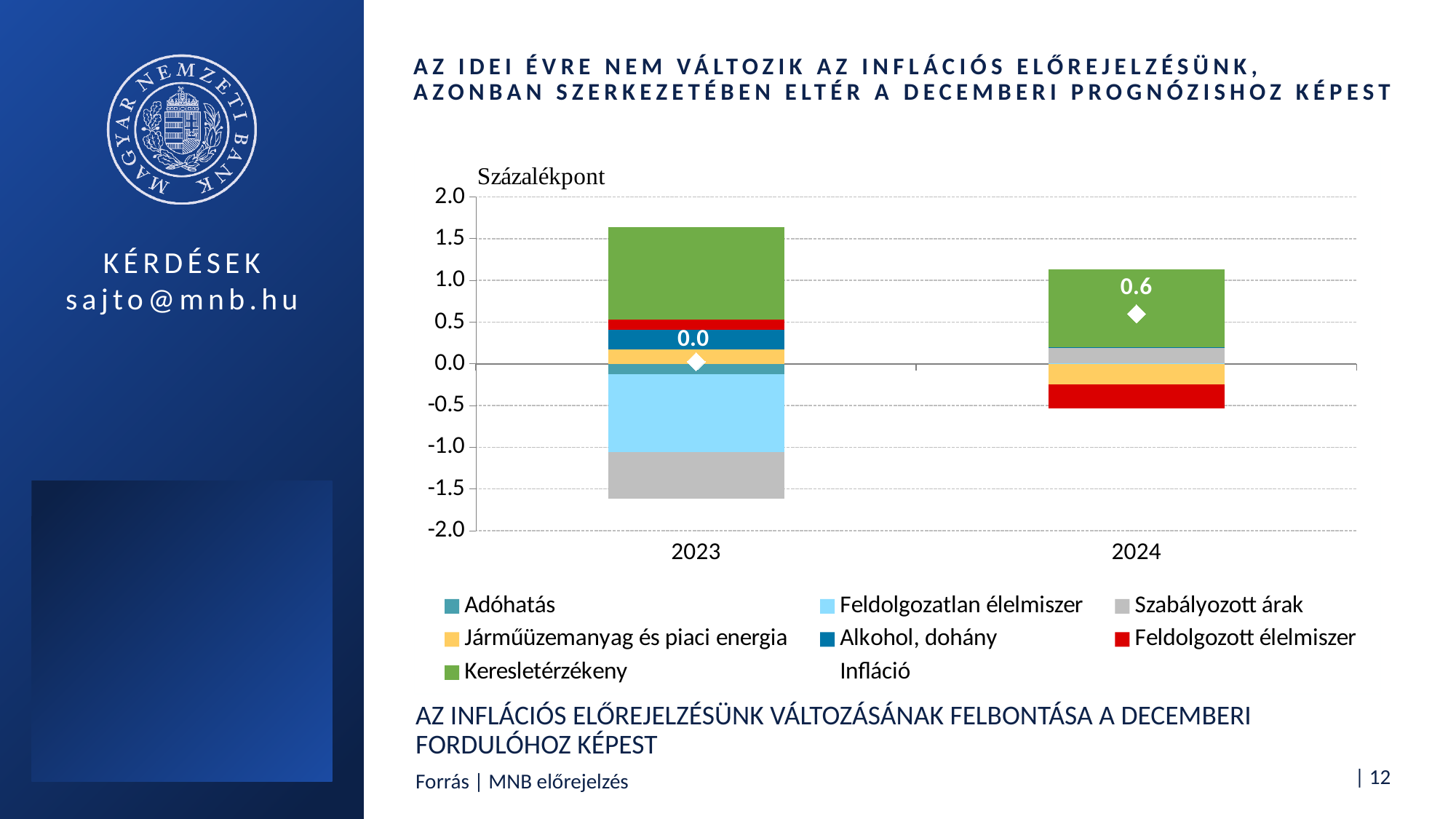
Is the Feldolgozatlan élelmiszer segment for 2023 greater or less than -0.5? less What is the value of the Infláció marker for 2023? 0.0 What unit label is shown above the vertical axis? Százalékpont What colour represents Keresletérzékeny in the legend? green What kind of chart is shown on the slide? stacked bar chart What is the difference between the Infláció values for 2024 and 2023? 0.6 What is the value of the Infláció marker for 2024? 0.6 How many categories (years) are shown on the x axis? 2 Which year has the higher Infláció value, 2023 or 2024? 2024 Does the Infláció value rise or fall from 2023 to 2024? rise Is the Keresletérzékeny segment for 2024 greater or less than 0.5? greater How many series does the legend list? 8